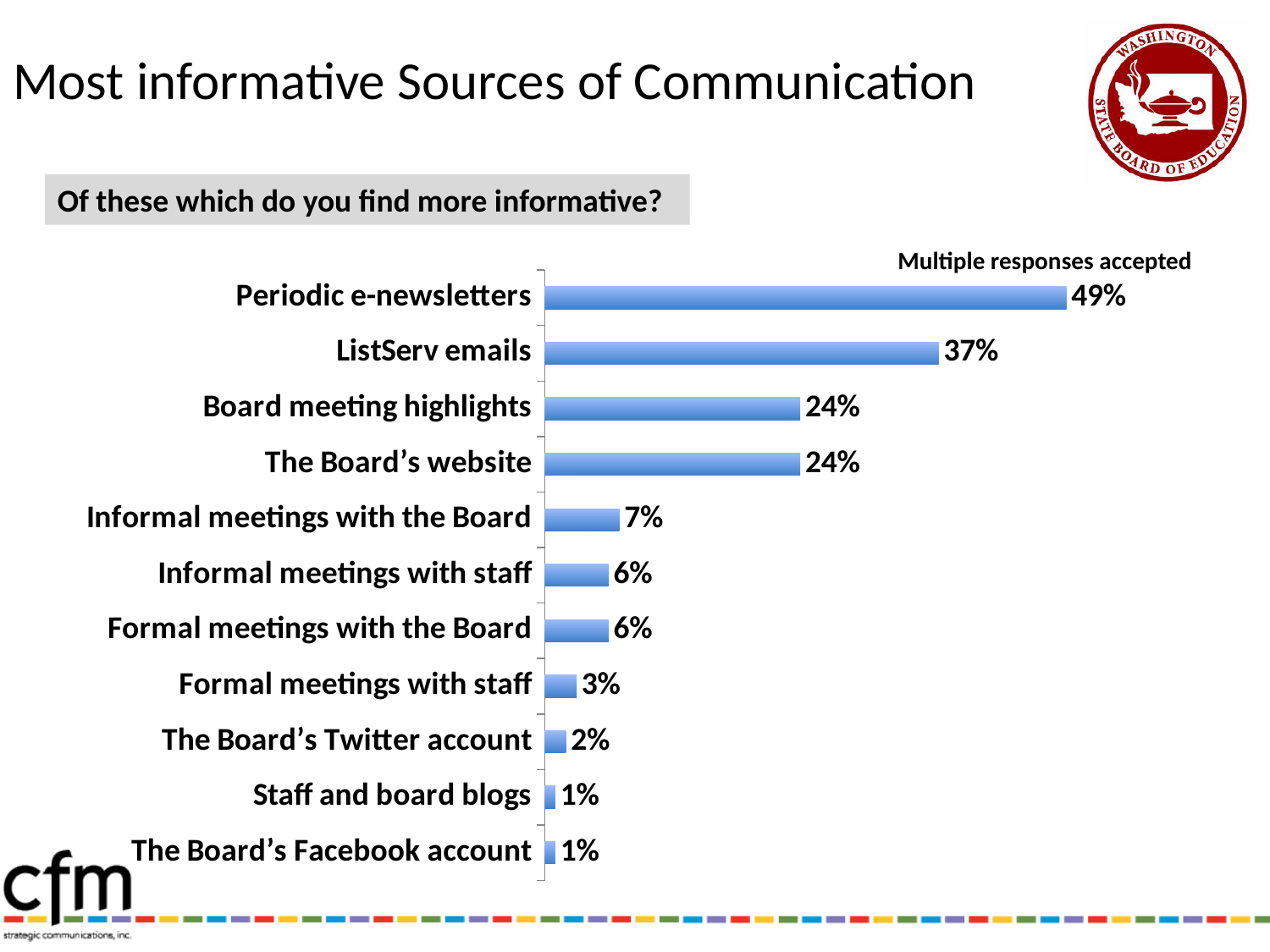
What is the difference between the values for Board meeting highlights and Formal meetings with staff? 21% What is the value shown for ListServ emails? 37% What percentage is shown for Informal meetings with the Board? 7% What percentage of respondents found periodic e-newsletters most informative? 49% How many sources of communication are listed in the chart? 11 Which source of communication has the highest percentage? Periodic e-newsletters What note appears above the chart about how responses were collected? Multiple responses accepted Which is larger, the value for Informal meetings with the Board or the value for Formal meetings with staff? Informal meetings with the Board What is the difference in percentage points between Periodic e-newsletters and ListServ emails? 12 What is the title of the slide? Most informative Sources of Communication What value is shown for The Board's Twitter account? 2% What type of chart is shown on the slide? Bar chart